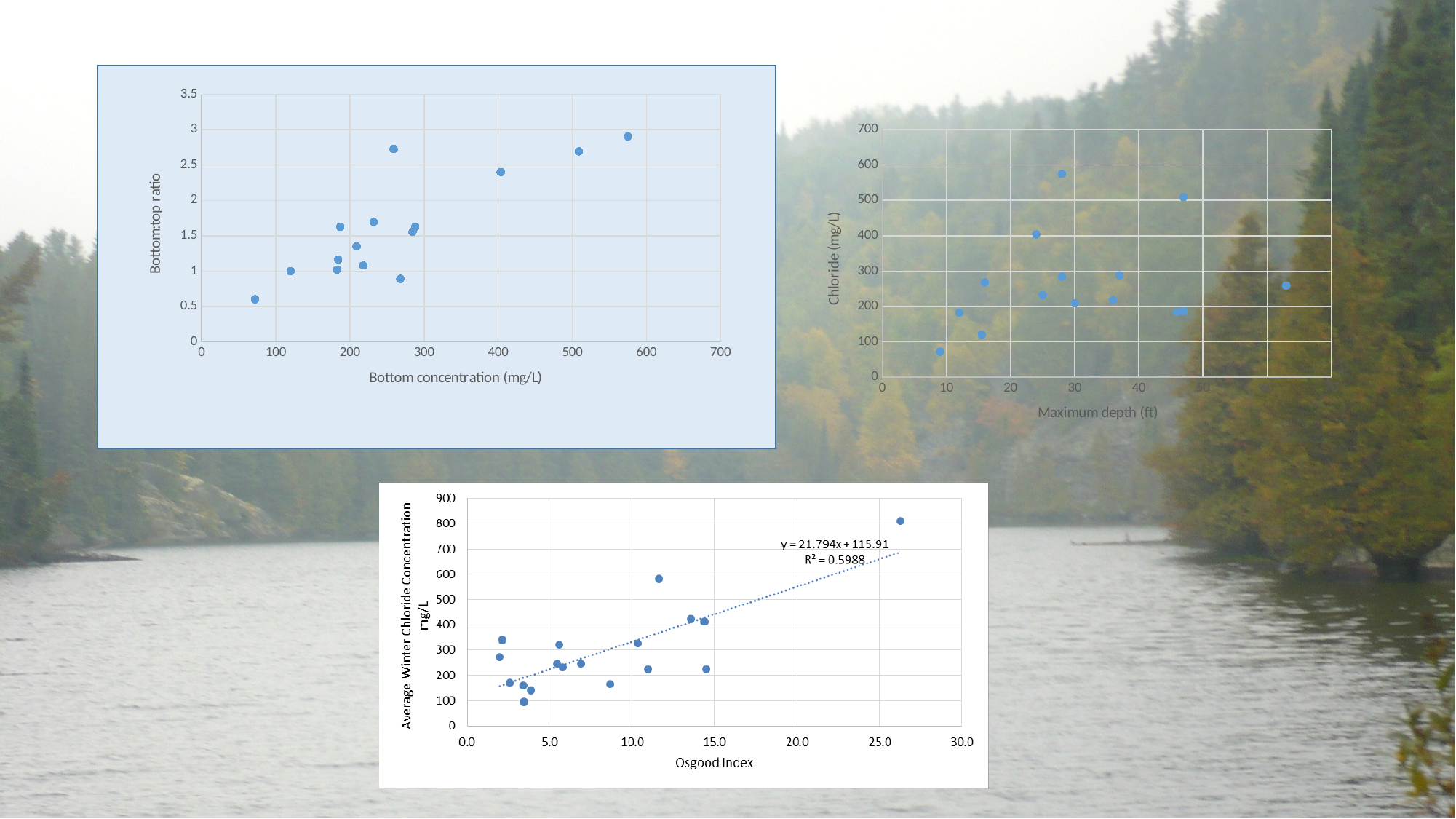
What kind of chart is the bottom chart with the Osgood Index on the x axis? scatter chart In the bottom chart, does the trendline rise or fall as the Osgood Index increases? rise In the top-right chart, is the highest chloride value plotted greater or less than 500? greater In the top-left chart, is the Bottom:top ratio of the point with the lowest bottom concentration greater or less than 1? less In the top-left chart, is the Bottom:top ratio of the point with the highest bottom concentration greater or less than 2.5? greater What kind of chart is the top-left chart? scatter chart In the bottom chart, what is the R² value shown for the trendline? 0.5988 In the top-left chart, what is the label of the x axis? Bottom concentration (mg/L) In the bottom chart, what is the trendline equation shown? y = 21.794x + 115.91 In the top-right chart, what is the label of the y axis? Chloride (mg/L) In the top-left chart, do the Bottom:top ratio values generally rise or fall as bottom concentration increases? rise